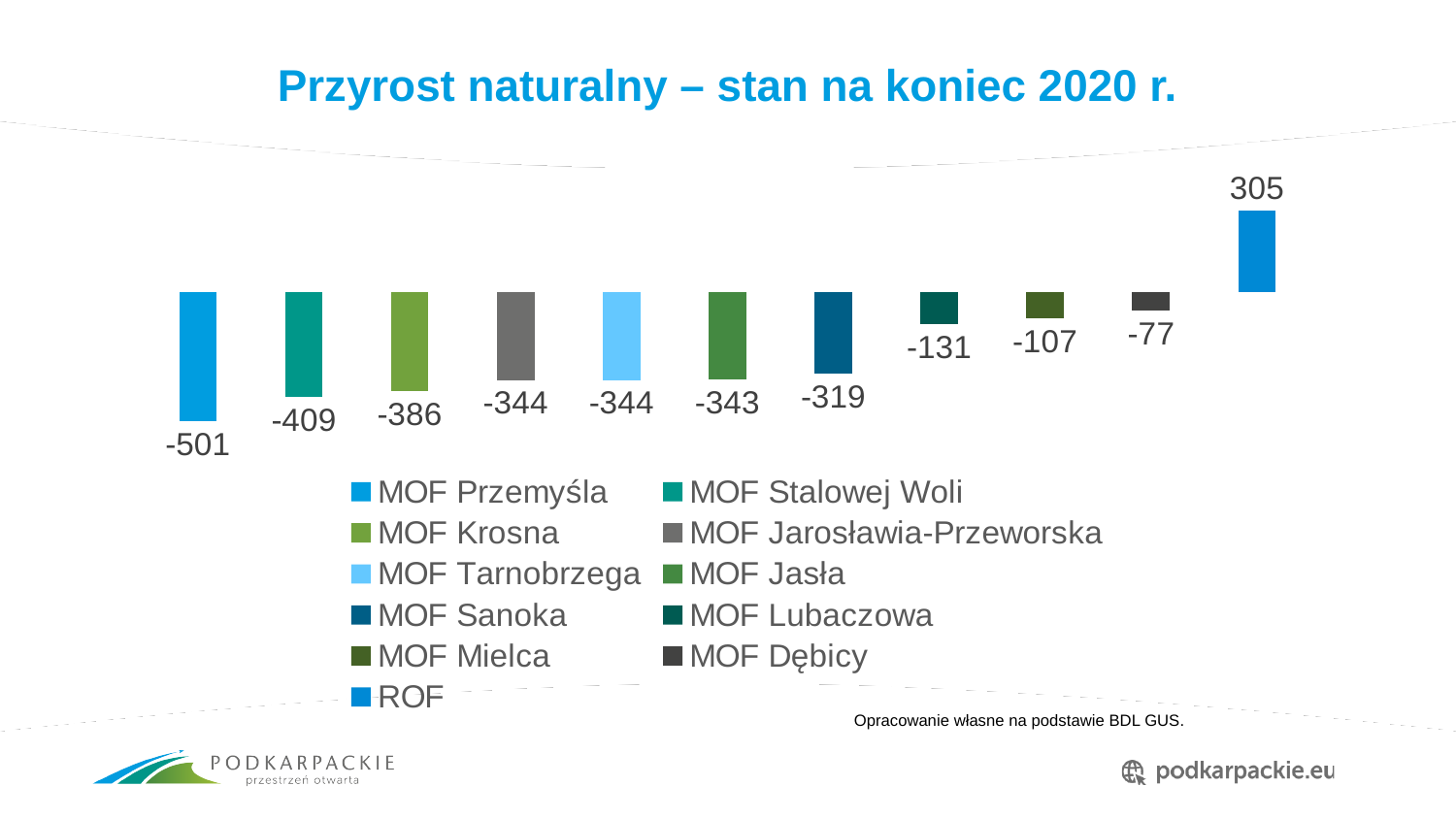
What is the value for MOF Przemyśla? -501 What is the value for MOF Sanoka? -319 How many series does the legend list? 11 Which series has the highest value? ROF What is the difference between the values for MOF Stalowej Woli and MOF Krosna? 23 What is the value for MOF Dębicy? -77 Which series has the lowest value? MOF Przemyśla What is the value for ROF? 305 What type of chart is shown on the slide? bar chart What is the title of the chart? Przyrost naturalny – stan na koniec 2020 r. What is the difference between the values for ROF and MOF Przemyśla? 806 Which is larger, the value for MOF Lubaczowa or the value for MOF Mielca? MOF Mielca